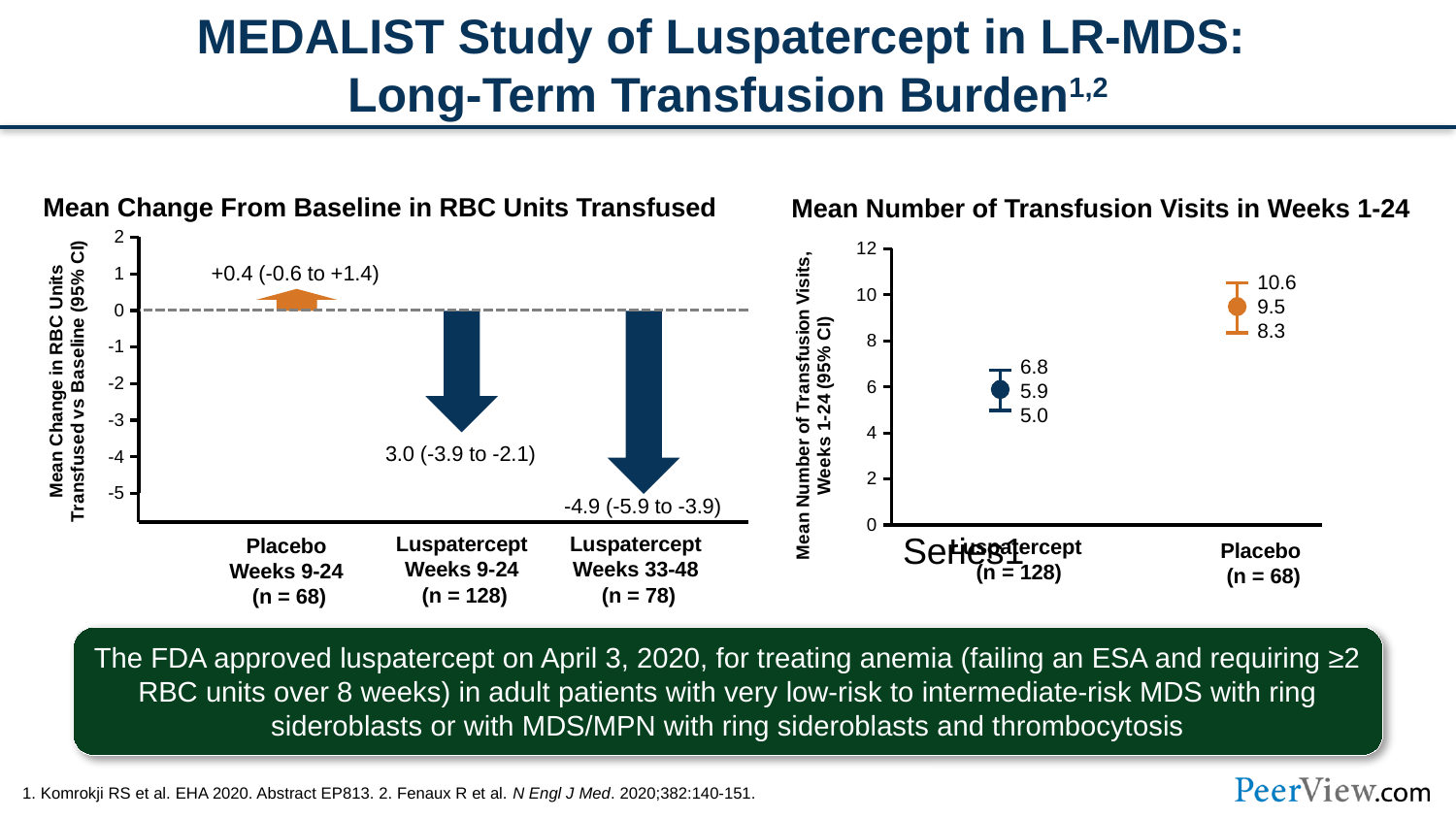
In the 'Mean Number of Transfusion Visits in Weeks 1-24' chart, which group has the higher mean number of transfusion visits, Luspatercept or Placebo? Placebo In the 'Mean Number of Transfusion Visits in Weeks 1-24' chart, what is the upper confidence bound labeled for Luspatercept? 6.8 In the 'Mean Change From Baseline in RBC Units Transfused' chart, what is the sample size shown for Luspatercept Weeks 33-48? n = 78 How many groups are plotted in the 'Mean Number of Transfusion Visits in Weeks 1-24' chart? 2 In the 'Mean Number of Transfusion Visits in Weeks 1-24' chart, is the mean value for Placebo greater or less than 8? greater In the 'Mean Number of Transfusion Visits in Weeks 1-24' chart, what is the difference between the Placebo and Luspatercept mean values? 3.6 In the 'Mean Change From Baseline in RBC Units Transfused' chart, which category has the lowest mean change from baseline? Luspatercept Weeks 33-48 In the 'Mean Number of Transfusion Visits in Weeks 1-24' chart, what is the mean number of transfusion visits for Luspatercept? 5.9 In the 'Mean Change From Baseline in RBC Units Transfused' chart, what is the mean change for Placebo Weeks 9-24? +0.4 How many categories are shown on the x axis of the 'Mean Change From Baseline in RBC Units Transfused' chart? 3 In the 'Mean Change From Baseline in RBC Units Transfused' chart, what is the mean change for Luspatercept Weeks 33-48? -4.9 In the 'Mean Number of Transfusion Visits in Weeks 1-24' chart, what is the mean number of transfusion visits for Placebo? 9.5